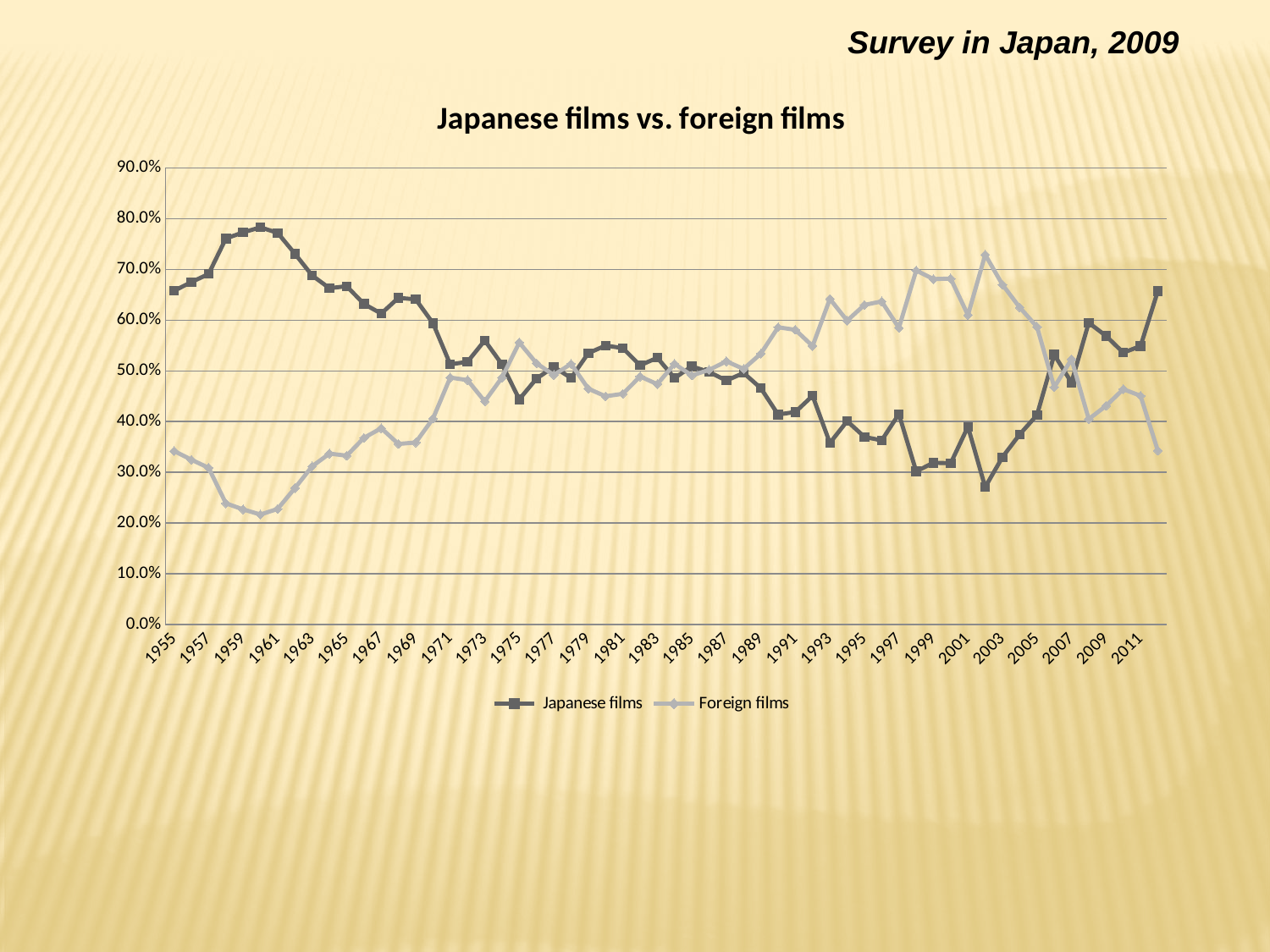
What kind of chart is shown on the slide? Line chart In 1995, which series has the higher value, Japanese films or Foreign films? Foreign films Is the value for Foreign films in 2003 greater or less than 70.0%? less Is the value for Japanese films in 1960 greater or less than 70.0%? greater In which year does the Foreign films series reach its highest value? 2002 Is the value for Foreign films in 1960 greater or less than 30.0%? less What is the title of the chart? Japanese films vs. foreign films How many series does the legend list? 2 In 1959, which series has the higher value, Japanese films or Foreign films? Japanese films Do the values for Japanese films rise or fall between 1961 and 1971? fall Which two series are listed in the legend? Japanese films and Foreign films